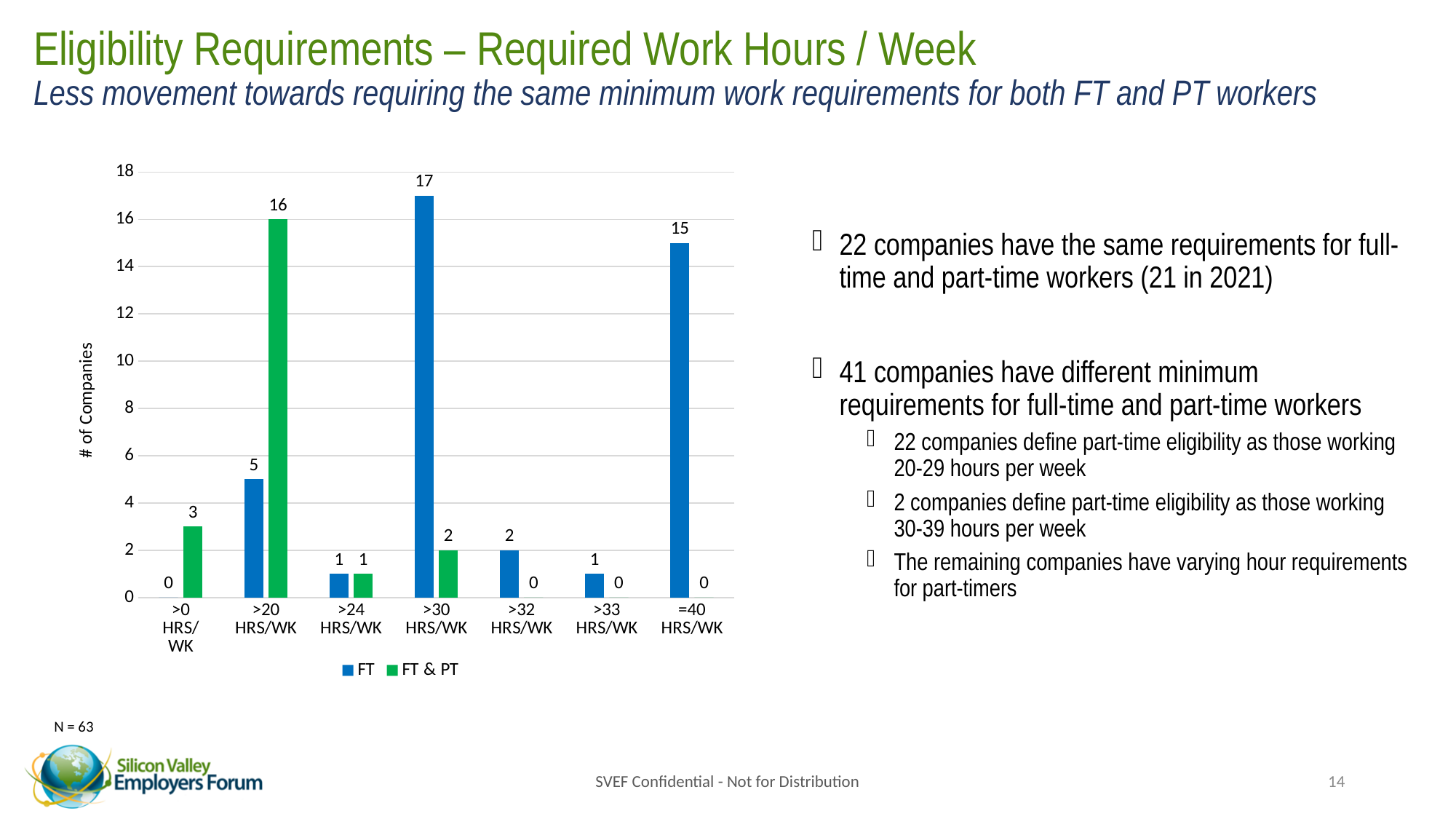
What kind of chart is shown on the slide? Bar chart What is the FT value for =40 HRS/WK? 15 What is the FT value for >30 HRS/WK? 17 How many categories are shown on the x axis? 7 Which is larger for >30 HRS/WK, the FT value or the FT & PT value? FT What is the difference between the FT and FT & PT values for >20 HRS/WK? 11 What is the FT & PT value for >20 HRS/WK? 16 How many series does the legend list? 2 What is the label of the y axis? # of Companies Which category has the highest FT & PT value? >20 HRS/WK Which category has the highest FT value? >30 HRS/WK What is the FT & PT value for >0 HRS/WK? 3